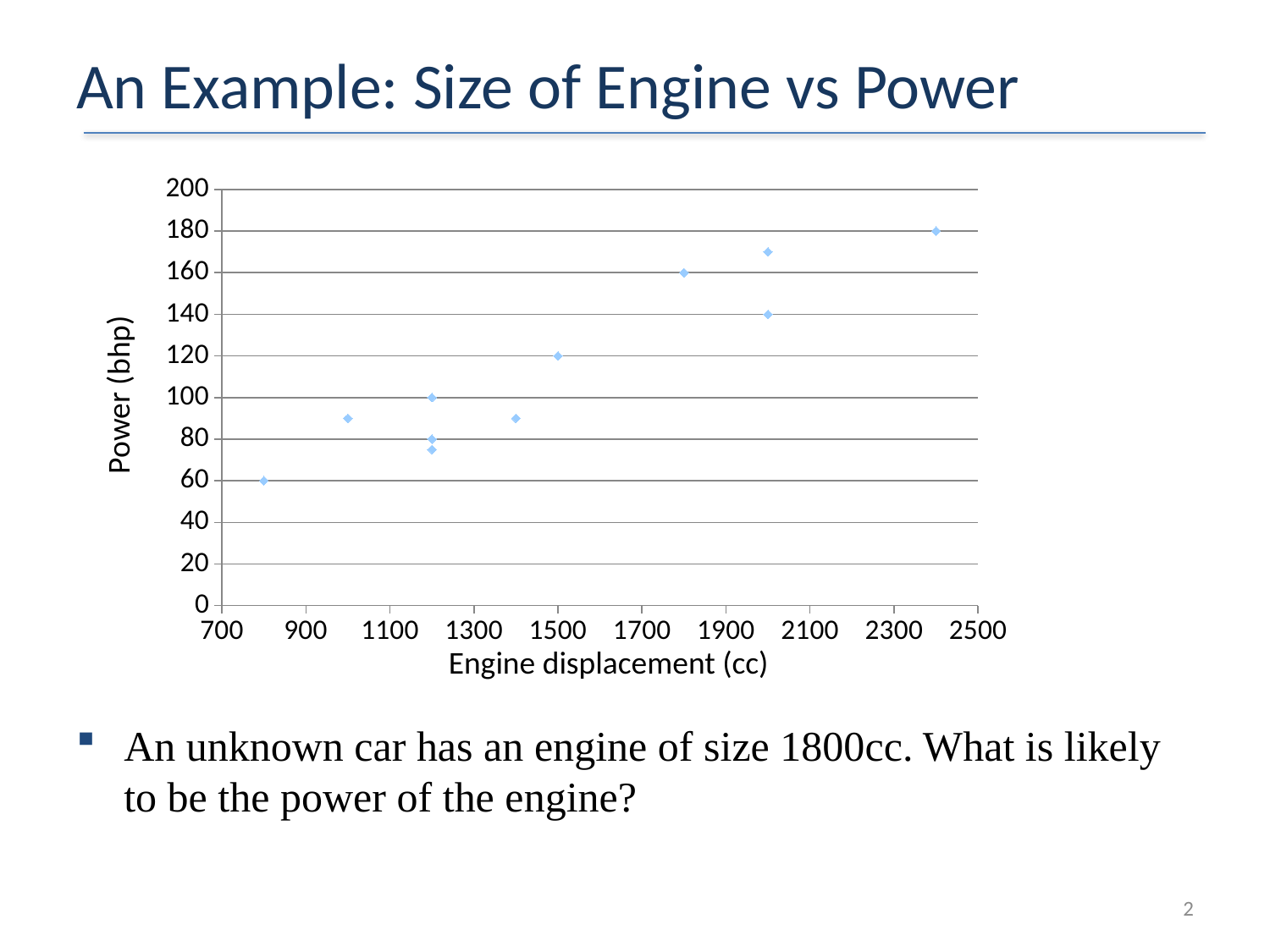
What kind of chart is shown on the slide? scatter plot Which has the higher power: the point at 1500 cc or the point at 800 cc? the point at 1500 cc What is the highest power value plotted on the chart? 180 Does power generally rise or fall as engine displacement increases? rise What is the lowest power value plotted on the chart? 60 Is the power of the rightmost point (largest engine displacement) greater or less than 160? greater What is the power value of the point at an engine displacement of 1500 cc? 120 Is the power of the leftmost point (smallest engine displacement) greater or less than 80? less What is the label of the vertical axis? Power (bhp) How many data points are plotted on the chart? 11 What is the difference in power between the highest point and the lowest point on the chart? 120 What is the title of the chart on the slide? An Example: Size of Engine vs Power